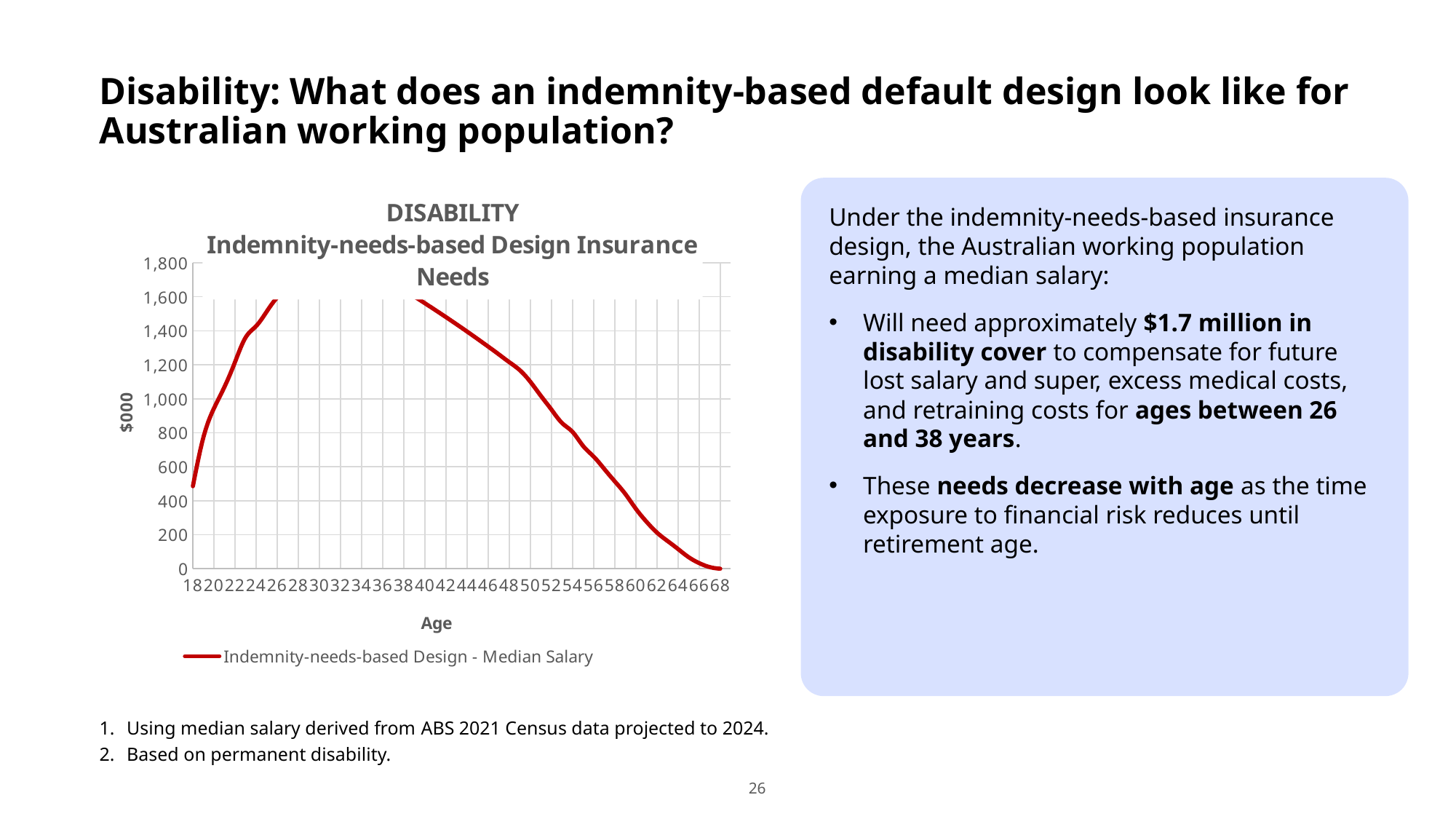
Do the values rise or fall along the x axis between age 18 and age 26? rise Is the value for age 40 greater or less than 1,400? greater Is the value for age 58 greater or less than 600? less Do the values rise or fall along the x axis between age 40 and age 68? fall Which is larger, the value for age 26 or the value for age 60? Age 26 How many series does the chart legend list? 1 Is the value for age 22 greater or less than 1,000? greater What kind of chart is shown on the slide? Line chart What is the label of the series in the chart legend? Indemnity-needs-based Design - Median Salary What is the label on the vertical axis of the chart? $000